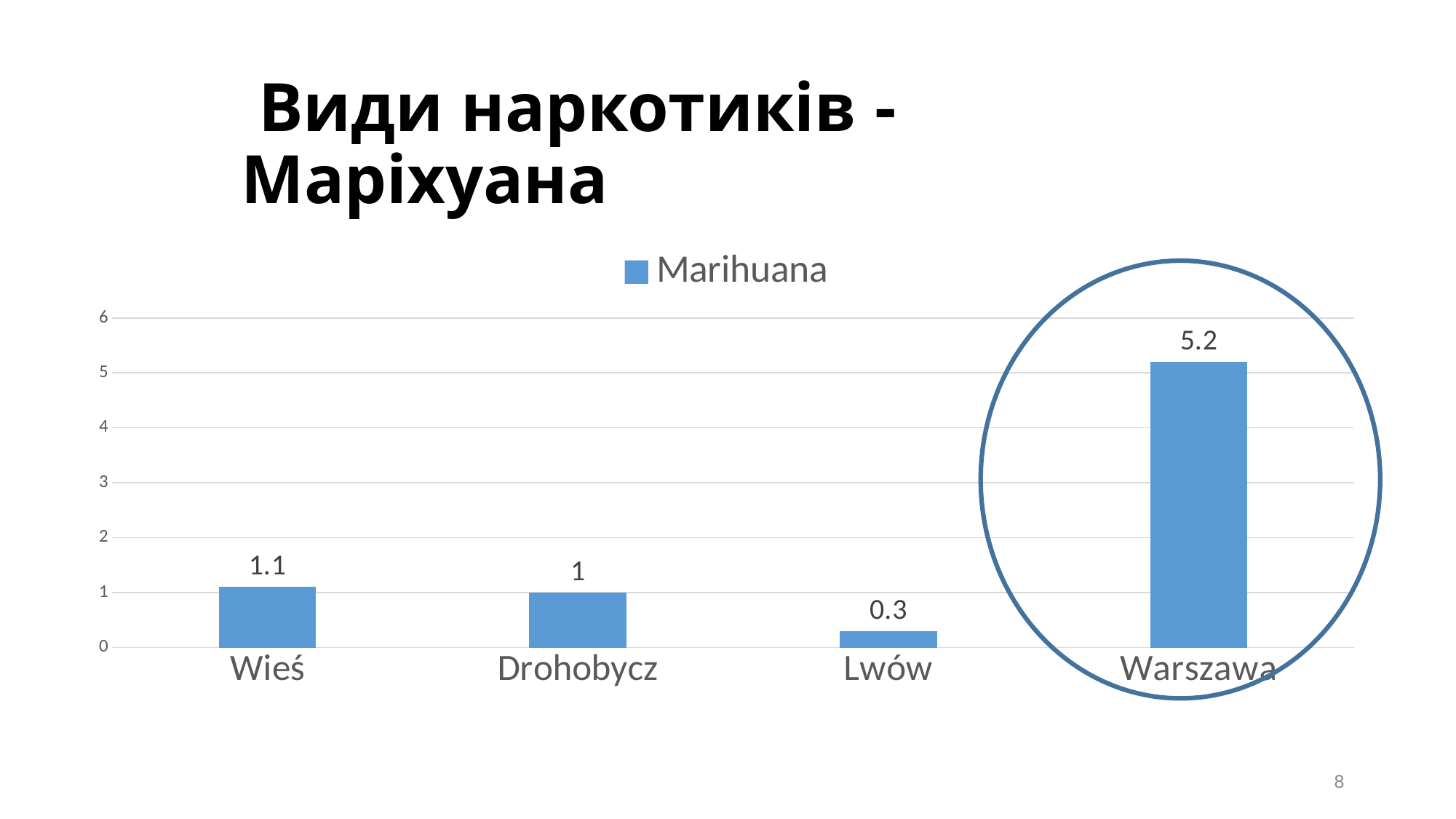
What kind of chart is shown on the slide? bar chart What is the value for Warszawa? 5.2 Which is larger, the value for Wieś or the value for Drohobycz? Wieś Which category has the highest value? Warszawa How many series does the legend list? 1 What is the value for Drohobycz? 1 Is the value for Warszawa greater or less than 4? greater What is the difference between the values for Warszawa and Wieś? 4.1 How many categories are shown on the x axis? 4 What is the value for Lwów? 0.3 What is the value for Wieś? 1.1 Which category has the lowest value? Lwów